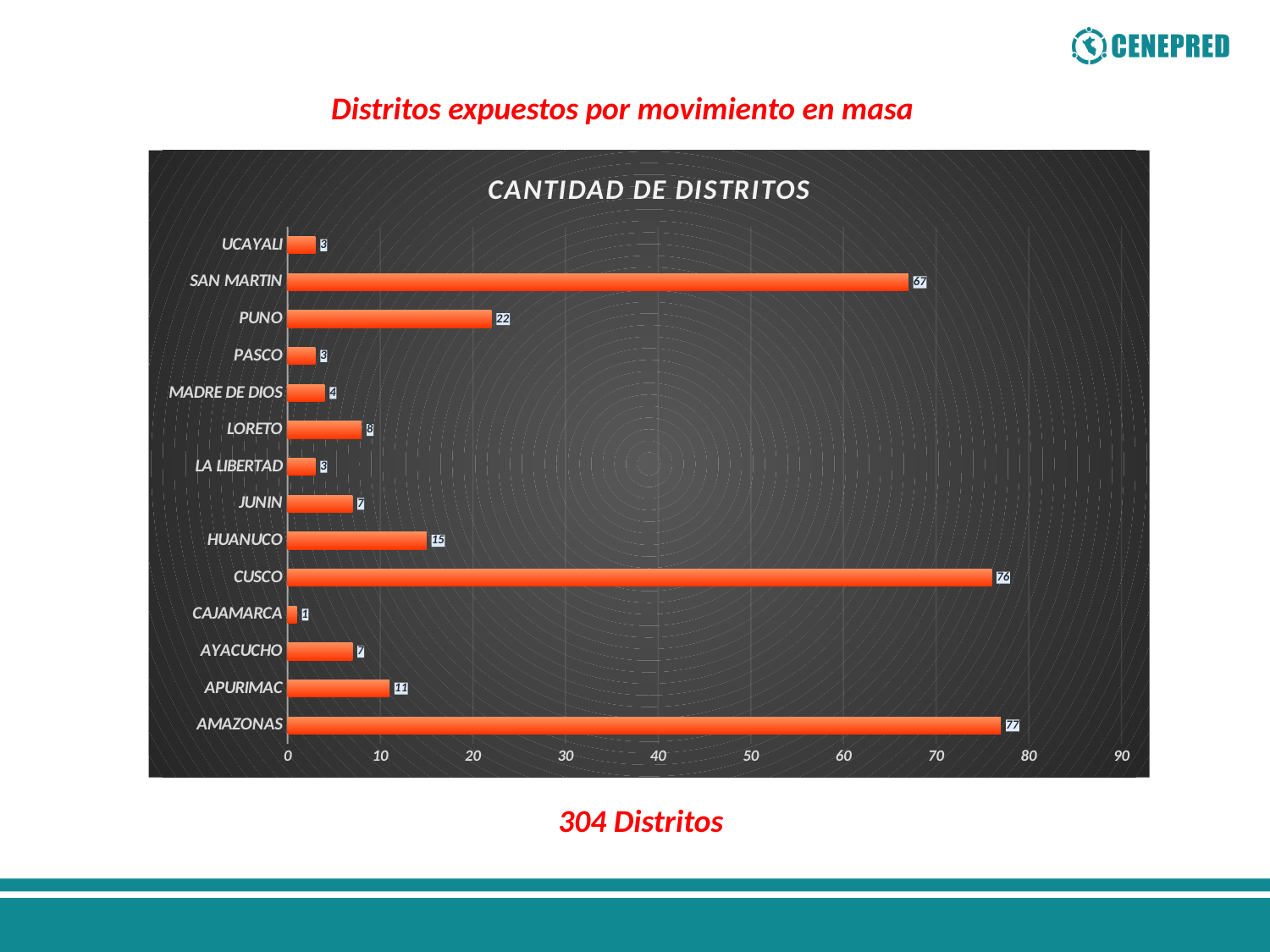
Which is larger, the value for LORETO or the value for JUNIN? LORETO What is the value for SAN MARTIN? 67 Which category has the highest value? AMAZONAS What is the difference between the values for SAN MARTIN and PUNO? 45 What is the value for PUNO? 22 What is the difference between the values for AMAZONAS and CUSCO? 1 What is the value for HUANUCO? 15 What is the title of the chart? CANTIDAD DE DISTRITOS What is the value for APURIMAC? 11 What kind of chart is shown on the slide? bar chart How many categories are shown in the chart? 14 Which category has the lowest value? CAJAMARCA